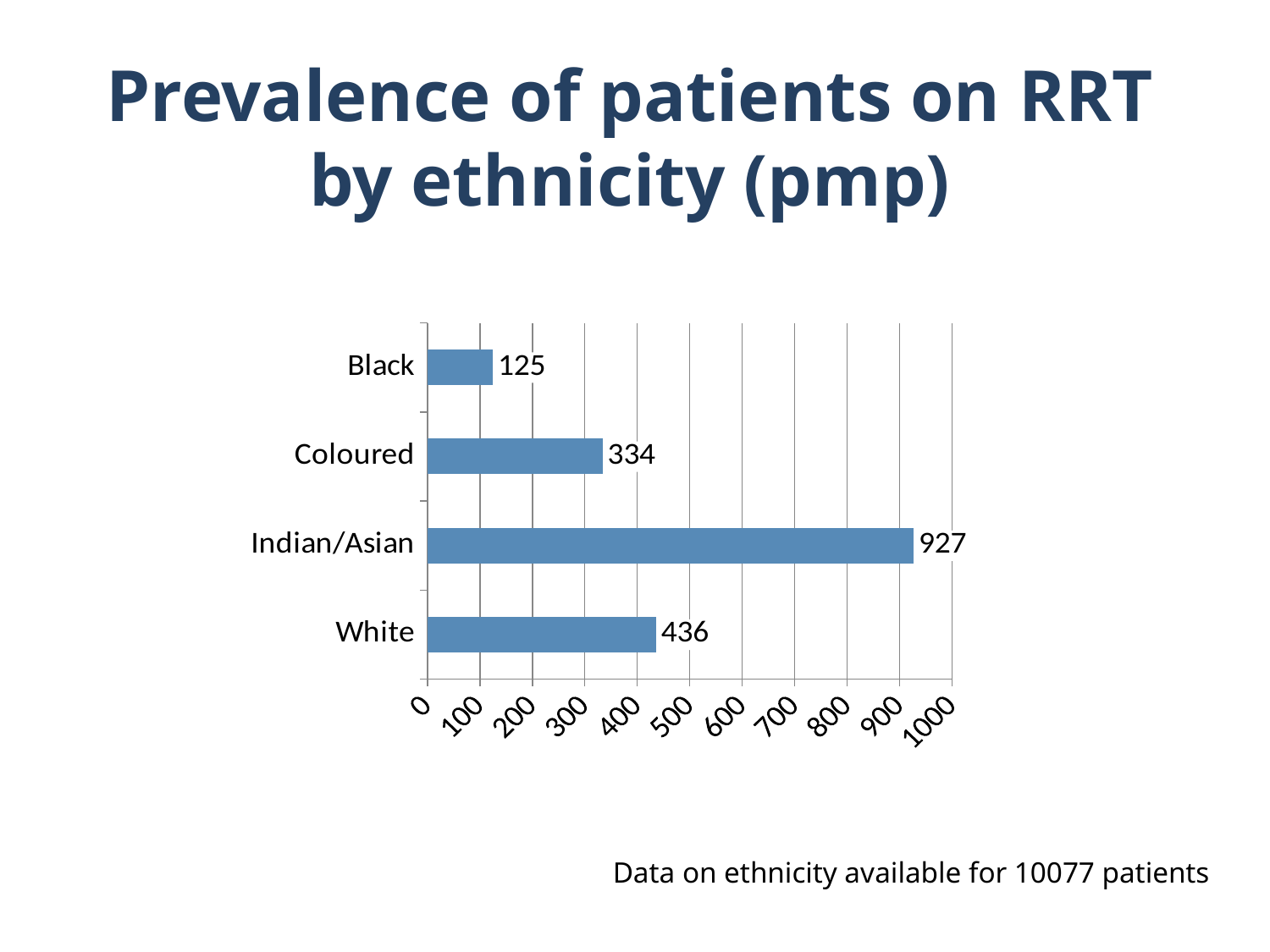
What is the difference in prevalence (pmp) between the White and Coloured groups? 102 What is the difference in prevalence (pmp) between the Indian/Asian and White groups? 491 According to the note on the slide, for how many patients was data on ethnicity available? 10077 patients Which group has a higher prevalence of patients on RRT, Coloured or White? White What is the prevalence of patients on RRT (pmp) for the Indian/Asian ethnicity group? 927 How many ethnicity groups are shown in the chart? 4 What is the prevalence of patients on RRT (pmp) for the Coloured ethnicity group? 334 What is the prevalence of patients on RRT (pmp) for the White ethnicity group? 436 Which ethnicity group has the highest prevalence of patients on RRT? Indian/Asian Which ethnicity group has the lowest prevalence of patients on RRT? Black What is the prevalence of patients on RRT (pmp) for the Black ethnicity group? 125 What kind of chart is shown on the slide? Bar chart